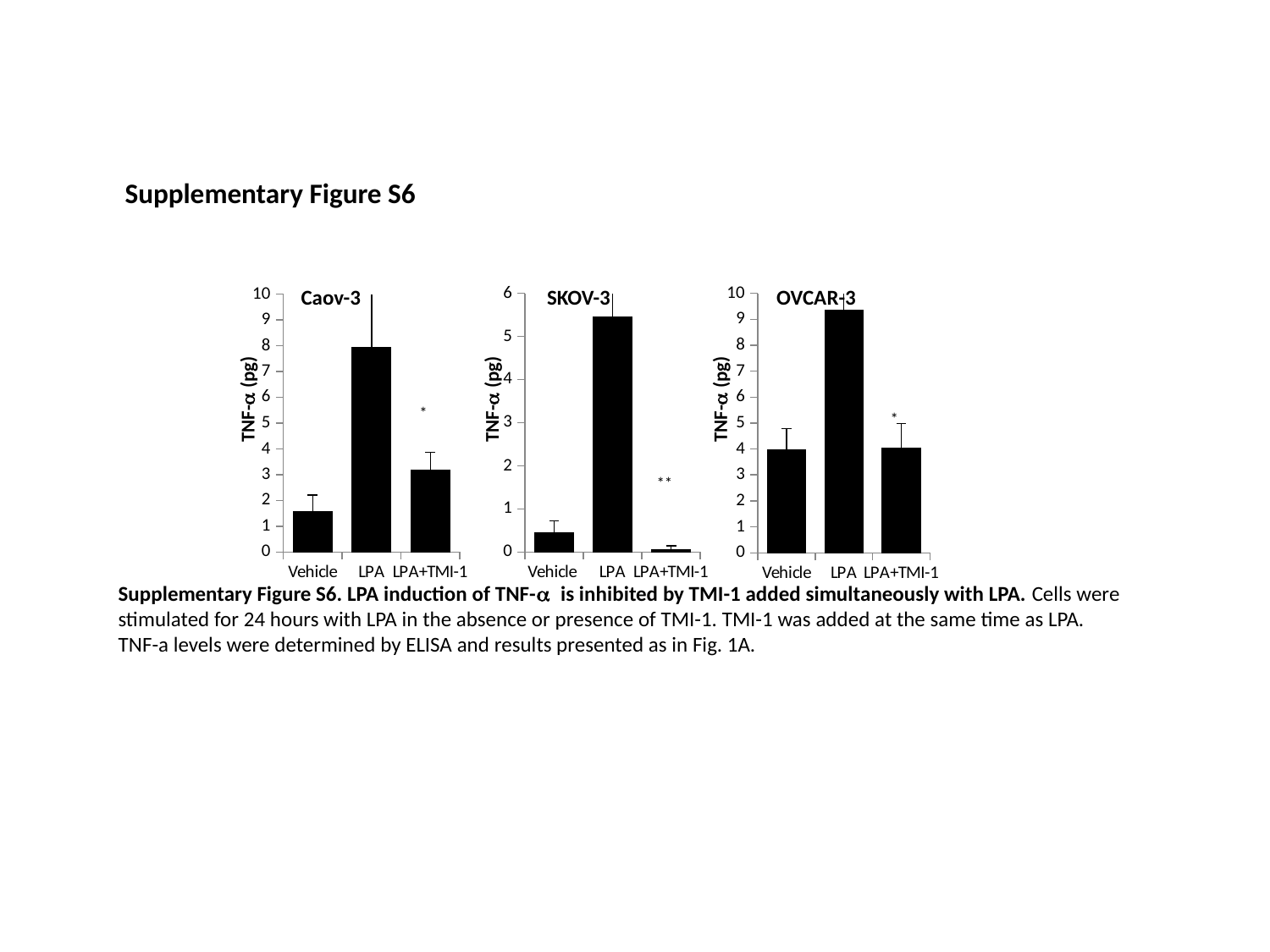
In the Caov-3 chart, is the value for LPA+TMI-1 greater or less than 4? less In the Caov-3 chart, is the value for LPA greater or less than 7? greater In the SKOV-3 chart, which category has the lowest TNF-α value? LPA+TMI-1 In the Caov-3 chart, which category has the highest TNF-α value? LPA How many categories are shown on the x axis of the OVCAR-3 chart? 3 What kind of chart is the SKOV-3 chart? bar chart In the SKOV-3 chart, which category has the highest TNF-α value? LPA In the OVCAR-3 chart, is the value for LPA greater or less than 9? greater In the SKOV-3 chart, which is larger, the value for Vehicle or the value for LPA+TMI-1? Vehicle In the Caov-3 chart, which category has the lowest TNF-α value? Vehicle In the OVCAR-3 chart, which category has the highest TNF-α value? LPA